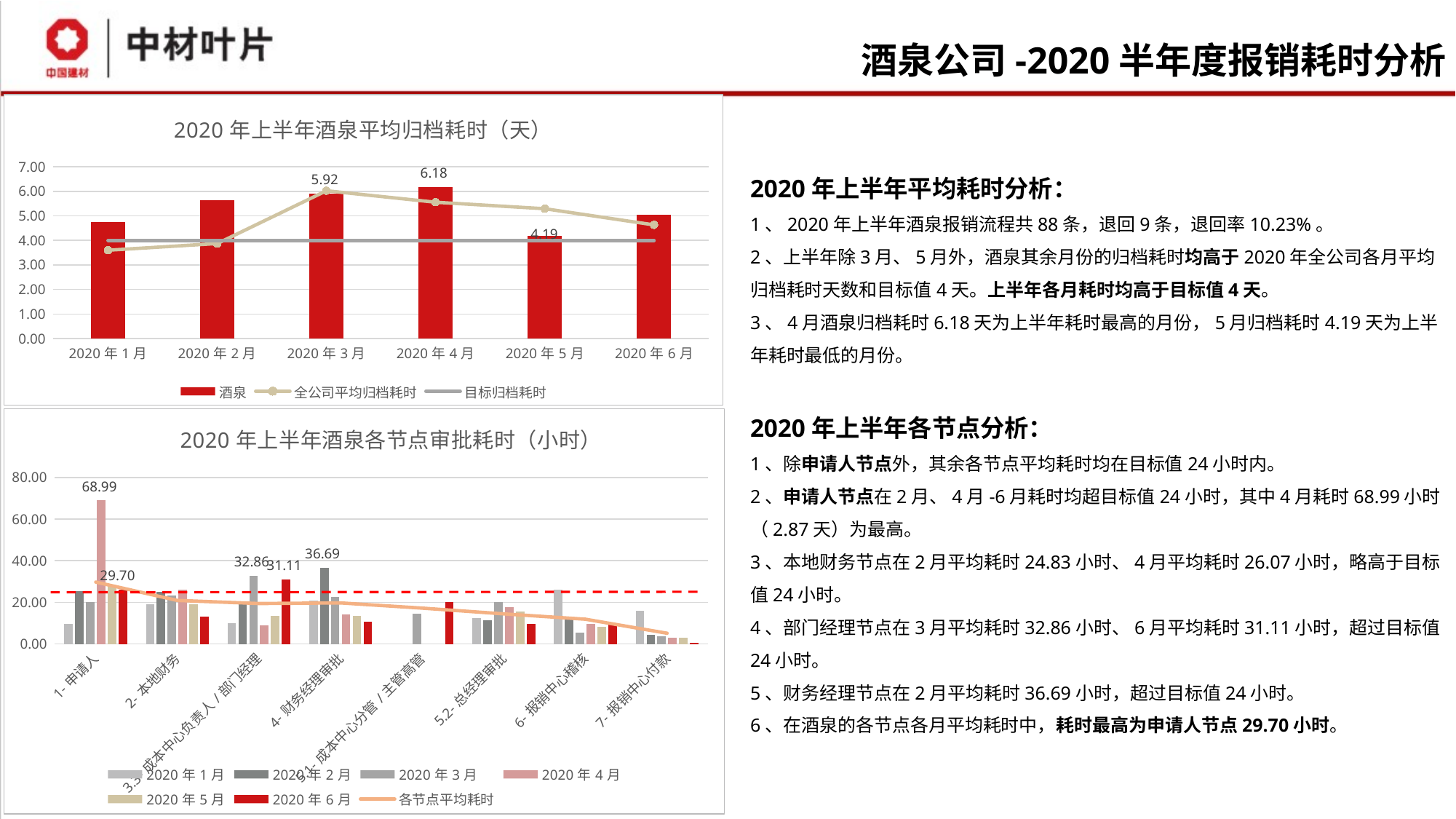
In the bottom chart '2020年上半年酒泉各节点审批耗时（小时）', does the 各节点平均耗时 line rise or fall from 1-申请人 to 7-报销中心付款? fall In the top chart '2020年上半年酒泉平均归档耗时（天）', which month has the highest 酒泉 bar? 2020年4月 In the top chart '2020年上半年酒泉平均归档耗时（天）', what is the difference between the 酒泉 values for 2020年4月 and 2020年5月? 1.99 In the top chart '2020年上半年酒泉平均归档耗时（天）', what is the 酒泉 value for 2020年3月? 5.92 In the top chart '2020年上半年酒泉平均归档耗时（天）', which month has the lowest 酒泉 bar? 2020年5月 In the bottom chart '2020年上半年酒泉各节点审批耗时（小时）', how many node categories are shown on the x axis? 8 In the top chart '2020年上半年酒泉平均归档耗时（天）', how many series does the legend list? 3 In the top chart '2020年上半年酒泉平均归档耗时（天）', what is the 酒泉 value for 2020年4月? 6.18 In the bottom chart '2020年上半年酒泉各节点审批耗时（小时）', what is the 2020年4月 value for 1-申请人? 68.99 In the top chart '2020年上半年酒泉平均归档耗时（天）', is the 酒泉 value for 2020年1月 greater or less than 4.00? greater In the bottom chart '2020年上半年酒泉各节点审批耗时（小时）', which is larger for 3-成本中心负责人/部门经理: the 2020年3月 value or the 2020年6月 value? 2020年3月 In the bottom chart '2020年上半年酒泉各节点审批耗时（小时）', what is the 2020年2月 value for 4-财务经理审批? 36.69